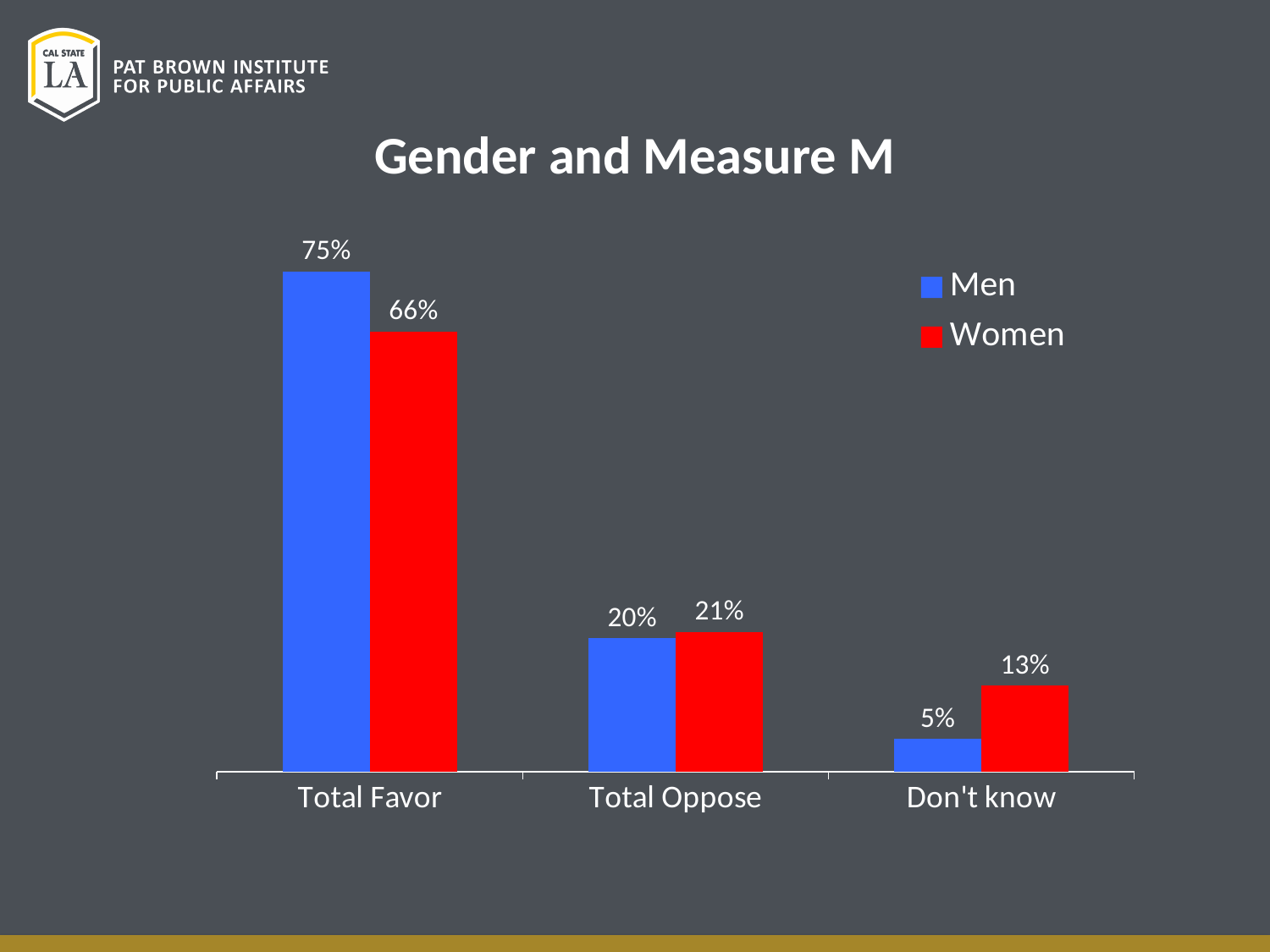
What kind of chart is shown on the slide? Bar chart Which category has the highest value for men? Total Favor In the Don't know category, which group has the larger value, men or women? Women What is the difference between the men's and women's values in the Total Favor category? 9% What is the value for men in the Total Oppose category? 20% What percentage of men are in the Total Favor category? 75% How many categories are shown on the x axis? 3 What is the value for women in the Don't know category? 13% What colour represents Women in the chart? Red How many series does the legend list? 2 Which category has the lowest value for women? Don't know What percentage of women are in the Total Favor category? 66%